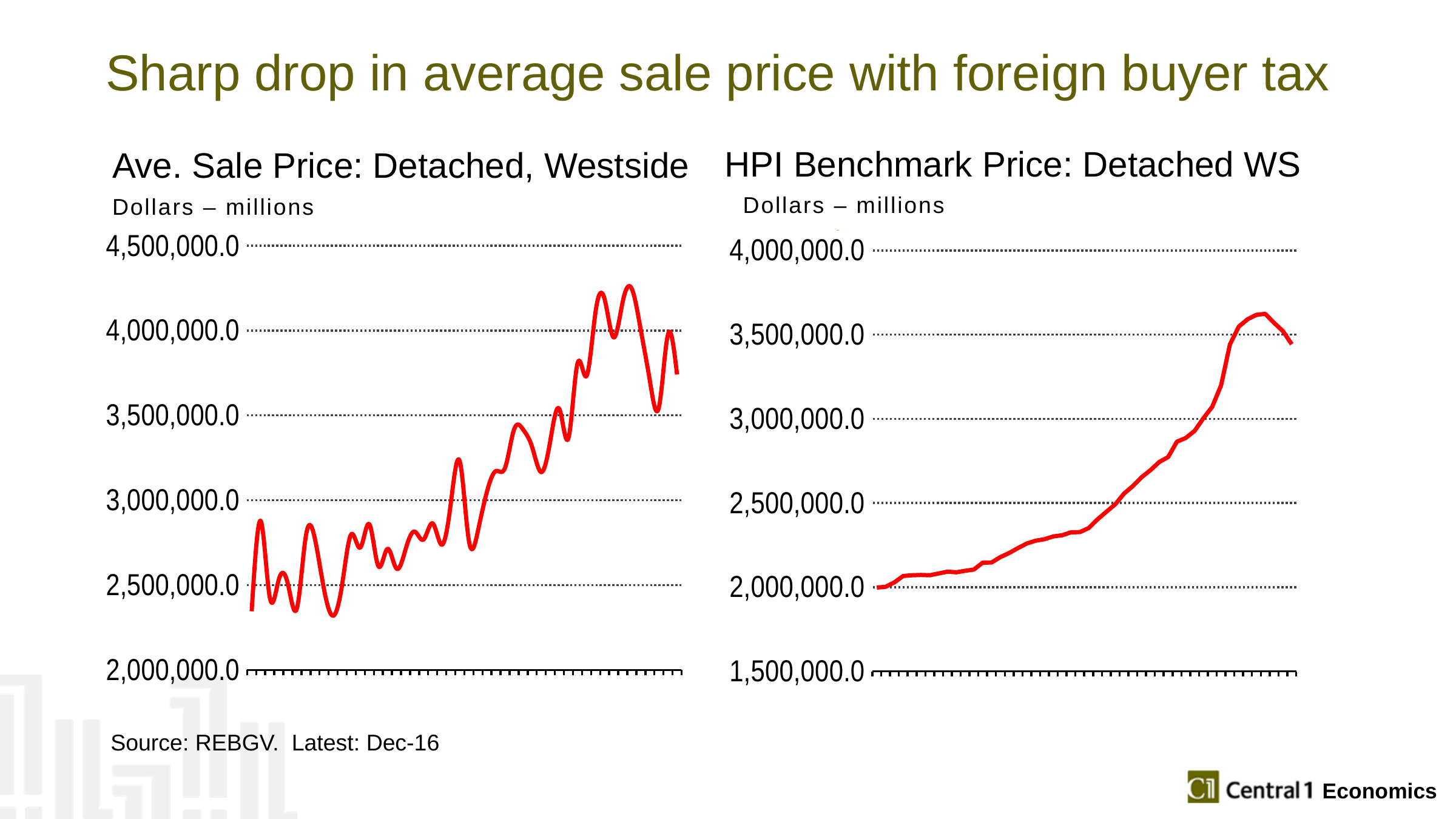
What kind of chart is the left chart, 'Ave. Sale Price: Detached, Westside'? Line chart What kind of chart is the right chart, 'HPI Benchmark Price: Detached WS'? Line chart In the left chart, 'Ave. Sale Price: Detached, Westside', is the final value at the right end of the line greater or less than 4,000,000.0? less In the left chart, 'Ave. Sale Price: Detached, Westside', is the highest point of the line greater or less than 4,000,000.0? greater In the left chart, 'Ave. Sale Price: Detached, Westside', is the lowest point of the line greater or less than 2,500,000.0? less What unit label is shown under the title of the left chart, 'Ave. Sale Price: Detached, Westside'? Dollars – millions In the left chart, 'Ave. Sale Price: Detached, Westside', do values overall rise or fall from left to right along the x axis? Rise In the right chart, 'HPI Benchmark Price: Detached WS', do values overall rise or fall from left to right along the x axis? Rise What colour is the line plotted in the right chart, 'HPI Benchmark Price: Detached WS'? Red